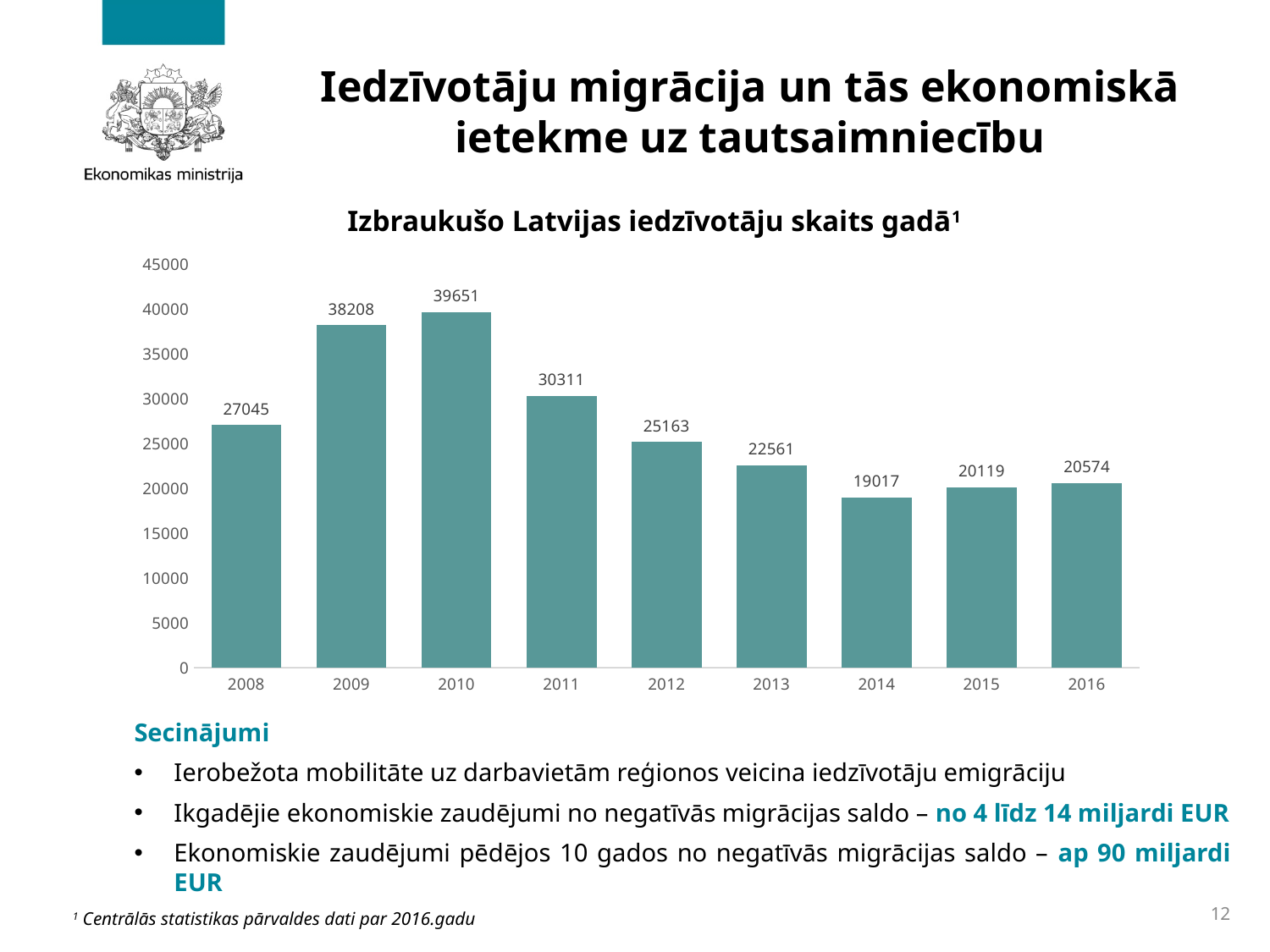
What is the value for 2010? 39651 What is the value for 2008? 27045 Which year has the lowest value? 2014 Is the value for 2011 greater or less than 30000? greater How many years are shown on the x axis? 9 What kind of chart is shown on the slide? bar chart What is the title of the chart? Izbraukušo Latvijas iedzīvotāju skaits gadā What is the value for 2014? 19017 Which year has the highest value? 2010 What is the difference between the values for 2010 and 2014? 20634 Which is larger, the value for 2012 or the value for 2013? 2012 What is the difference between the values for 2009 and 2008? 11163